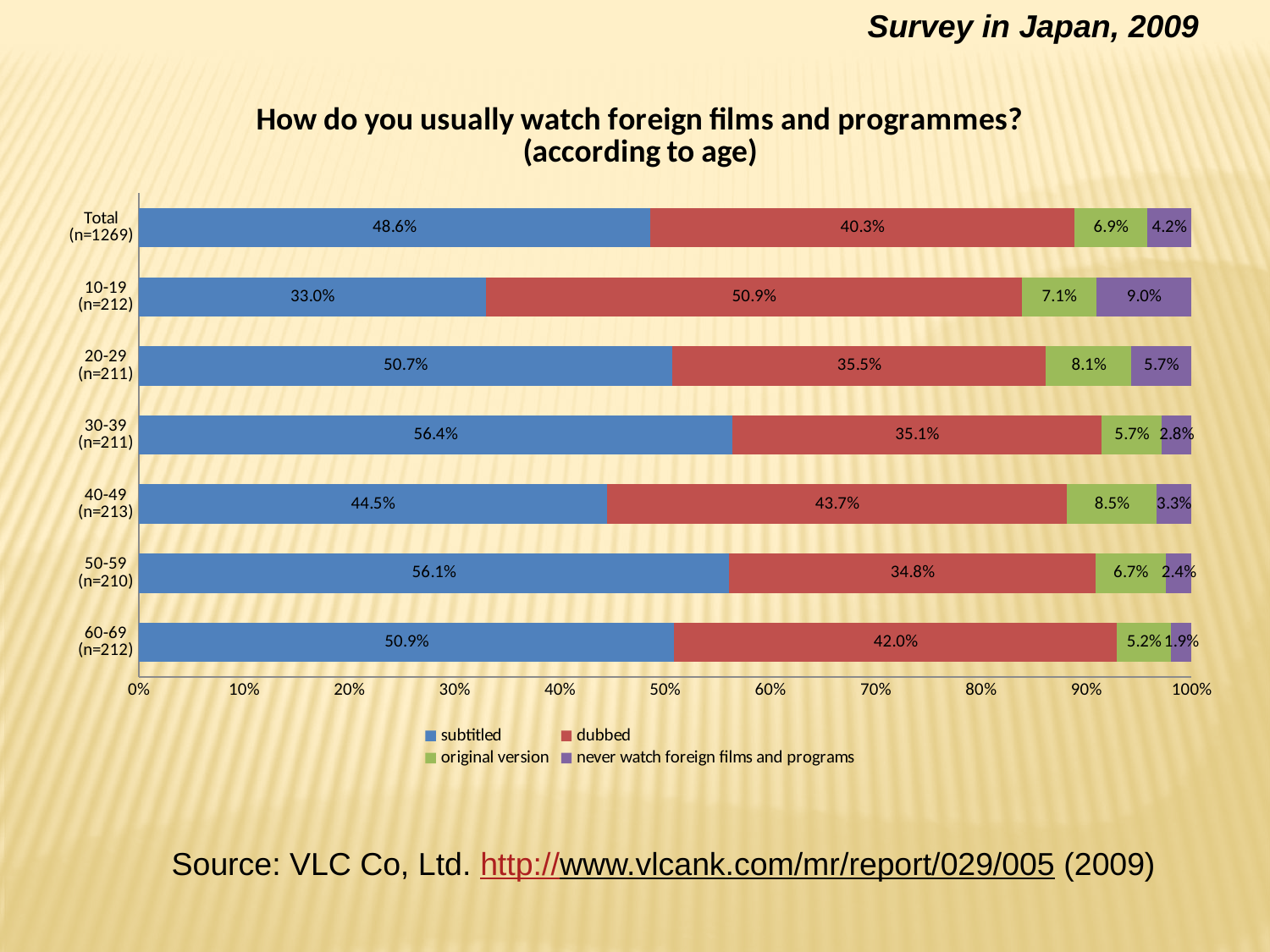
How many series does the legend list? 4 What is the dubbed share for the 10-19 age group? 50.9% What percentage of the 40-49 age group watch the original version? 8.5% What type of chart is shown on the slide? Stacked bar chart What is the 'never watch foreign films and programs' value for the 10-19 group? 9.0% How many age categories (including Total) are shown on the chart? 7 For the Total row, how many percentage points higher is subtitled than dubbed? 8.3 What percentage of the 30-39 age group usually watch foreign films subtitled? 56.4% Which age group has the lowest subtitled percentage? 10-19 Which has a larger dubbed share, the 40-49 group or the 60-69 group? 40-49 Which age group has the highest dubbed percentage? 10-19 What colour represents 'dubbed' in the chart? Red